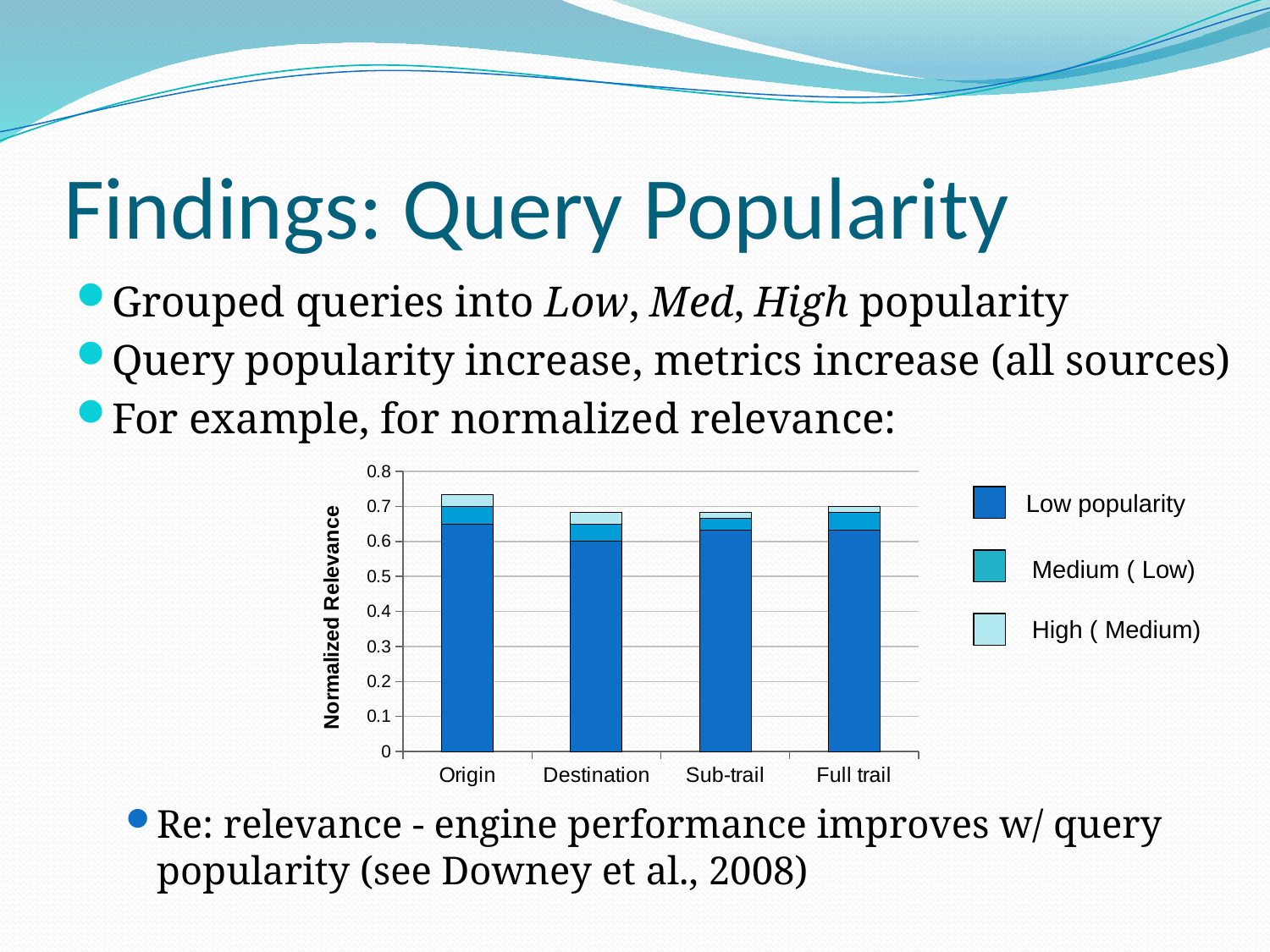
How many categories are shown on the x axis of the chart? 4 Which category has the lowest Low popularity value? Destination How many series does the chart's legend list? 3 Is the Low popularity value for Origin greater or less than 0.6? greater Which category has the tallest stacked bar overall? Origin What is the title of the vertical axis of the chart? Normalized Relevance What kind of chart is shown on the slide? stacked bar chart Is the Low popularity value for Destination greater or less than 0.7? less Is the total height of the stacked bar for Full trail greater or less than 0.8? less Which has the larger Low popularity value, Origin or Destination? Origin Which series is listed first in the chart's legend? Low popularity